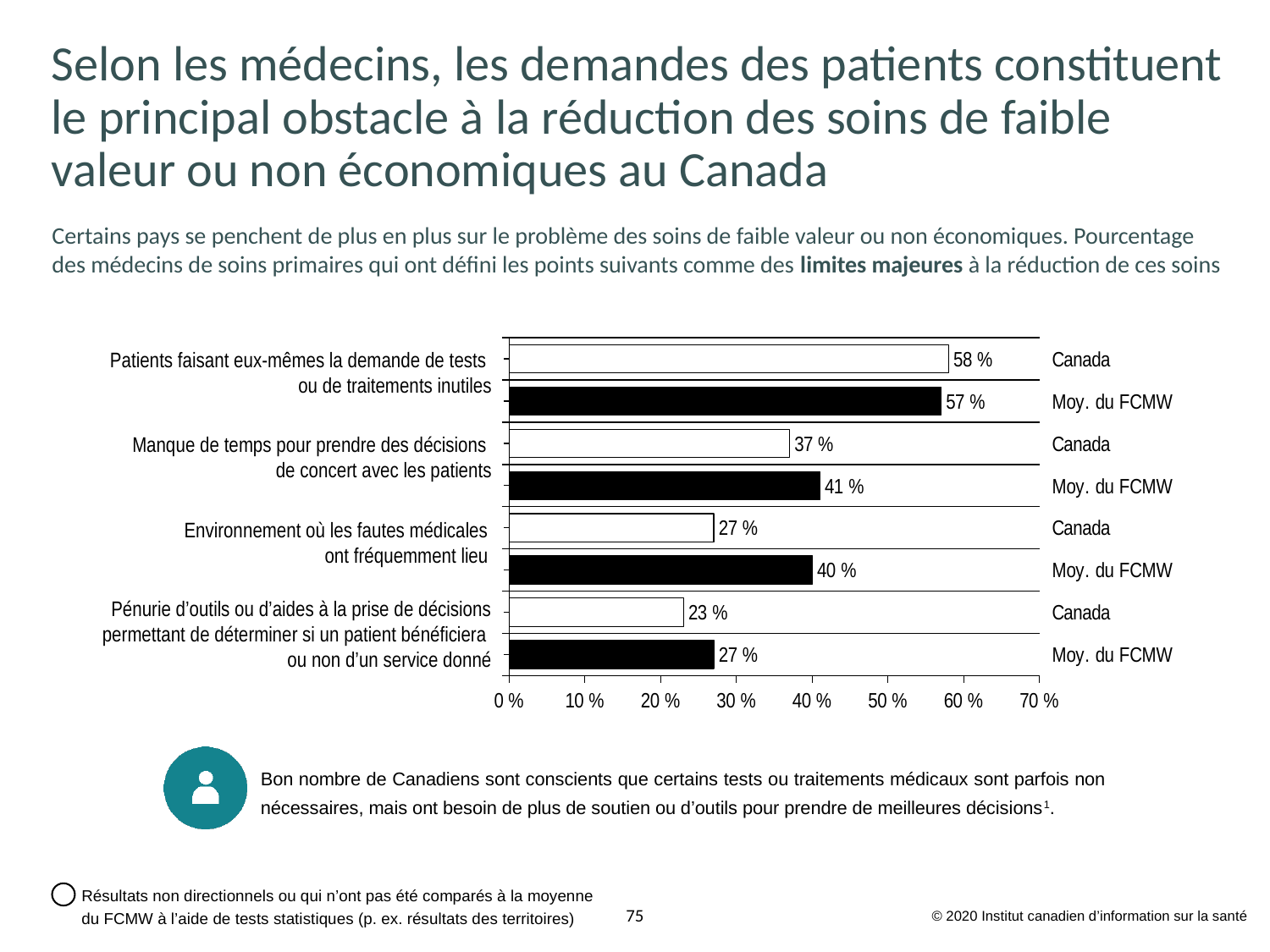
Which category has the highest Canada value? Patients faisant eux-mêmes la demande de tests ou de traitements inutiles What is the Canada value for "Environnement où les fautes médicales ont fréquemment lieu"? 27 % What is the Canada value for "Patients faisant eux-mêmes la demande de tests ou de traitements inutiles"? 58 % What is the difference between the Moy. du FCMW value and the Canada value for "Environnement où les fautes médicales ont fréquemment lieu"? 13 % Is the Canada value for "Pénurie d'outils ou d'aides à la prise de décisions" greater or less than 30 %? less What is the Moy. du FCMW value for "Pénurie d'outils ou d'aides à la prise de décisions permettant de déterminer si un patient bénéficiera ou non d'un service donné"? 27 % For "Manque de temps pour prendre des décisions de concert avec les patients", which is larger: the Canada value or the Moy. du FCMW value? Moy. du FCMW What is the Moy. du FCMW value for "Manque de temps pour prendre des décisions de concert avec les patients"? 41 % Which category has the lowest Canada value? Pénurie d'outils ou d'aides à la prise de décisions permettant de déterminer si un patient bénéficiera ou non d'un service donné How many categories are shown on the chart? 4 How many series does the chart show for each category? 2 What kind of chart is shown on the slide? Bar chart